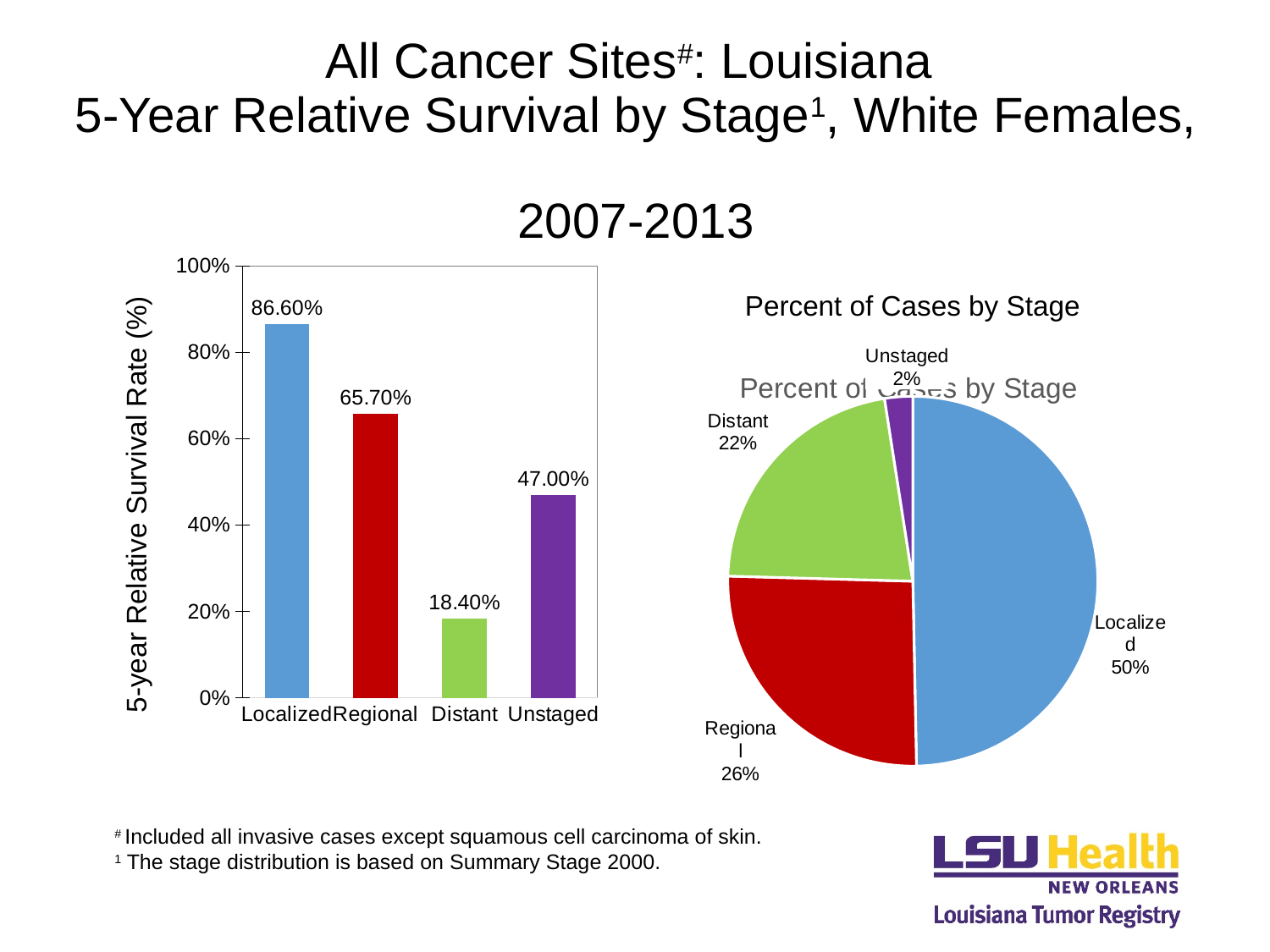
In the bar chart on the left, which stage has the highest 5-year relative survival rate? Localized In the bar chart on the left, which stage has the lowest 5-year relative survival rate? Distant In the pie chart 'Percent of Cases by Stage', what share of cases is Regional? 26% In the bar chart on the left, which has a higher survival rate, Regional or Unstaged? Regional In the bar chart on the left, how many stage categories are shown? 4 In the bar chart on the left, what is the difference between the survival rates for Localized and Regional stages? 20.90% In the bar chart on the left, what is the 5-year relative survival rate for Distant stage? 18.40% What is the y-axis label of the bar chart on the left? 5-year Relative Survival Rate (%) In the bar chart on the left, what is the 5-year relative survival rate for Localized stage? 86.60% What type of chart is shown on the left side of the slide? Bar chart In the pie chart 'Percent of Cases by Stage', which stage has the largest share of cases? Localized In the pie chart 'Percent of Cases by Stage', which stage has the smallest share of cases? Unstaged